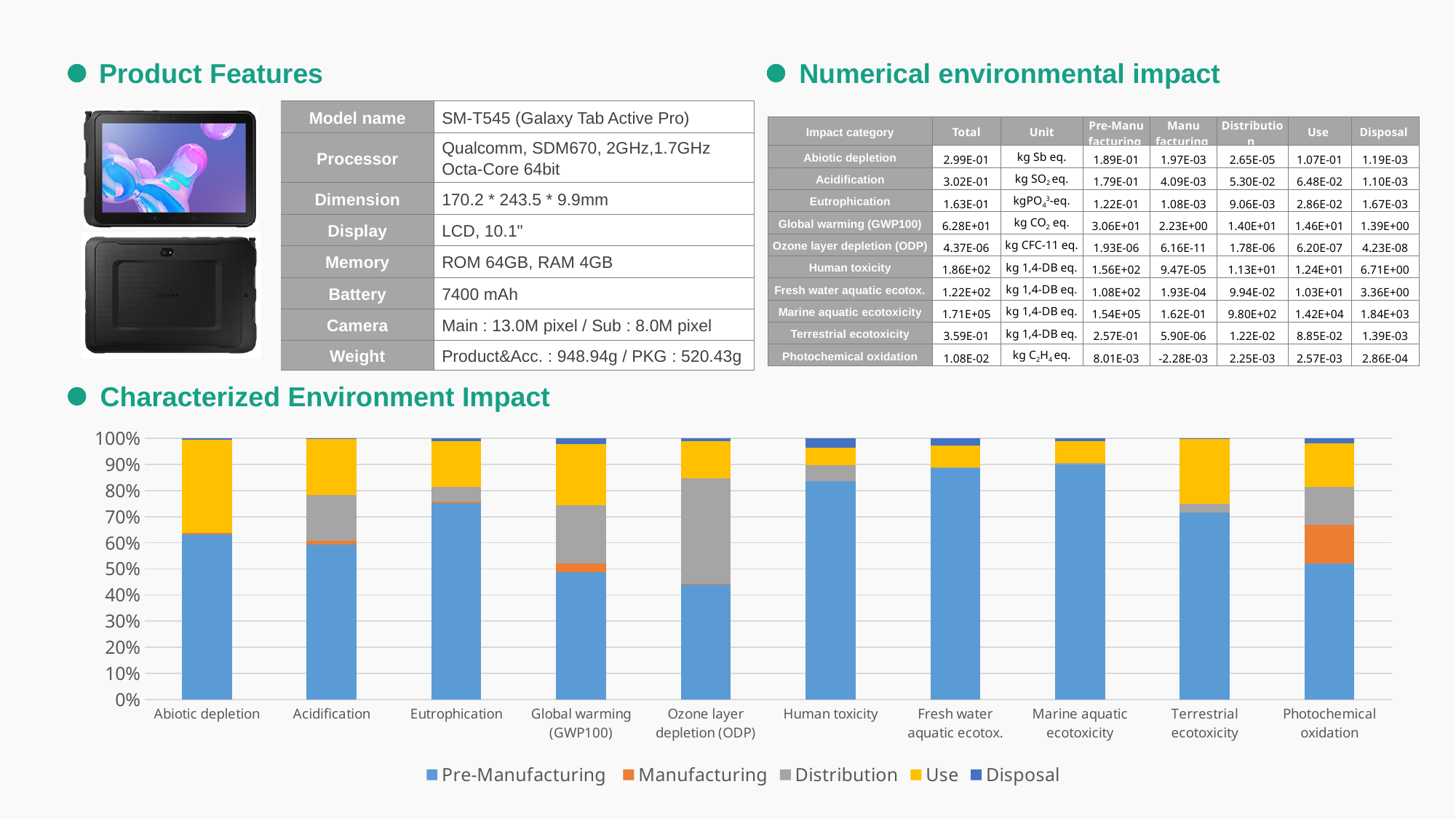
In the Characterized Environment Impact chart, is the Pre-Manufacturing share larger for Human toxicity or for Acidification? Human toxicity In the Characterized Environment Impact chart, which impact category has the smallest Pre-Manufacturing share? Ozone layer depletion (ODP) In the Characterized Environment Impact chart, which impact category has the largest Use share? Abiotic depletion In the Characterized Environment Impact chart, is the Distribution share larger for Ozone layer depletion (ODP) or for Eutrophication? Ozone layer depletion (ODP) In the Characterized Environment Impact chart, is the Pre-Manufacturing share for Marine aquatic ecotoxicity greater or less than 80%? greater How many impact categories are plotted along the x axis of the Characterized Environment Impact chart? 10 What colour represents the Use series in the Characterized Environment Impact chart? Yellow What kind of chart is shown under 'Characterized Environment Impact'? Stacked bar chart How many series does the legend of the Characterized Environment Impact chart list? 5 In the Characterized Environment Impact chart, is the Pre-Manufacturing share for Ozone layer depletion (ODP) greater or less than 50%? less In the Characterized Environment Impact chart, is the Pre-Manufacturing share for Abiotic depletion greater or less than 60%? greater